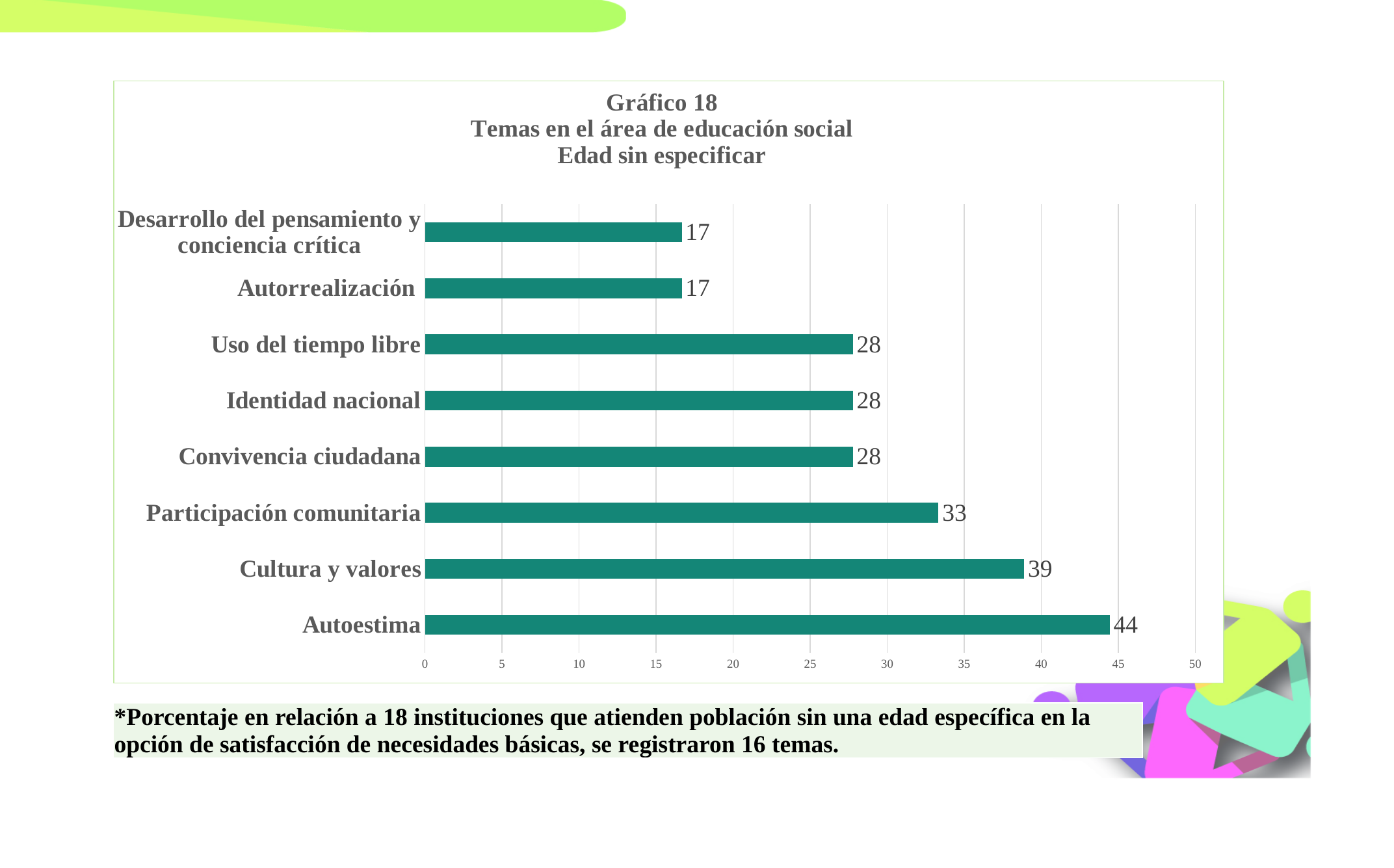
What is the difference between the values for Participación comunitaria and Uso del tiempo libre? 5 Which category has the highest value? Autoestima What is the number of the chart given in its title? Gráfico 18 How many categories are shown in the chart? 8 What kind of chart is shown on the slide? bar chart What is the value for Participación comunitaria? 33 Which is larger, the value for Cultura y valores or the value for Identidad nacional? Cultura y valores What is the value for Cultura y valores? 39 Is the value for Participación comunitaria greater or less than 30? greater What is the value for Autorrealización? 17 What is the difference between the values for Autoestima and Cultura y valores? 5 What is the value for Autoestima? 44